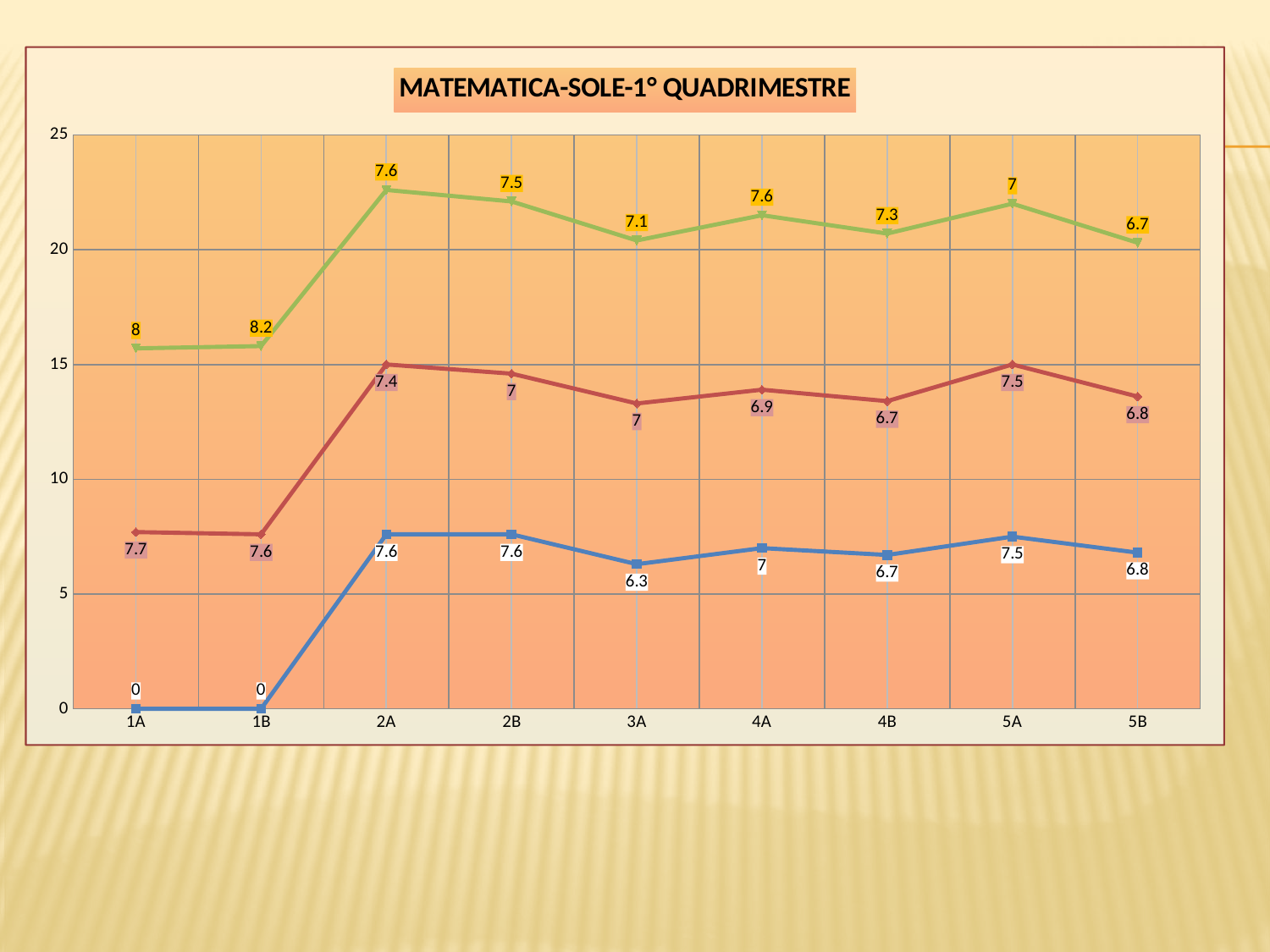
What is the data label for the blue line at 3A? 6.3 What is the data label for the red line at 5A? 7.5 What is the title of the chart? MATEMATICA-SOLE-1° QUADRIMESTRE At which category does the green line have its highest data label? 1B What is the difference between the green line's data labels at 1B and 5B? 1.5 What kind of chart is shown on the slide? line chart How many lines are plotted on the chart? 3 How many categories are shown on the x axis? 9 For the blue line, which is larger: the data label at 2A or at 3A? 2A What is the data label for the blue line at 1A? 0 What is the data label for the green line at 1B? 8.2 At which category does the red line have its lowest data label? 4B